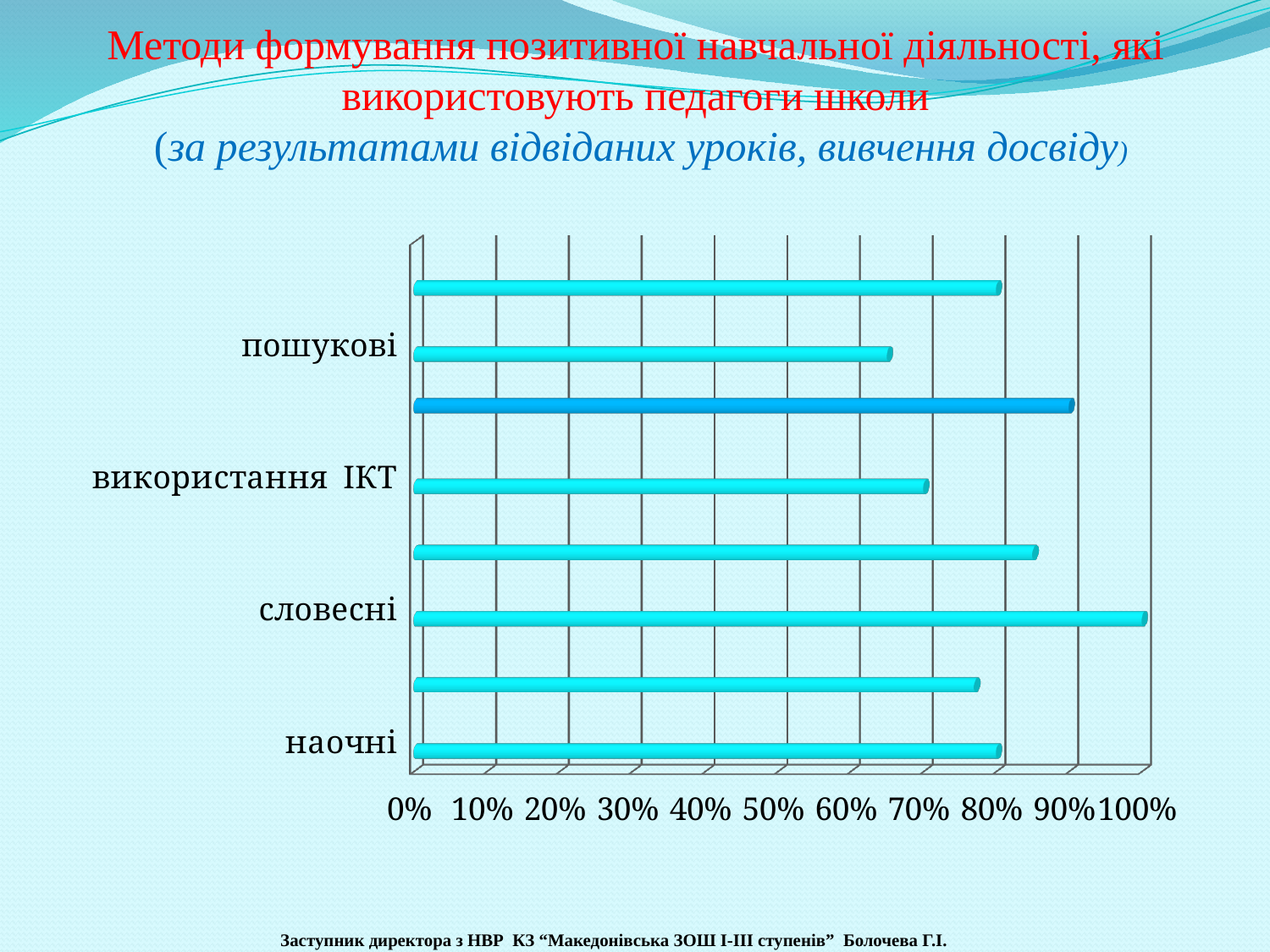
Is the value for використання ІКТ greater or less than 80%? less Which is larger, the value for словесні or the value for пошукові? словесні Which labelled category has the shortest bar? пошукові How many bars are plotted in the chart? 8 Is the value for пошукові greater or less than 70%? less Which is larger, the value for наочні or the value for використання ІКТ? наочні What is the interval between tick labels on the horizontal axis? 10% Is the value for словесні greater or less than 90%? greater What is the highest value shown on the horizontal axis? 100% What kind of chart is shown on the slide? bar chart Which labelled category has the longest bar? словесні